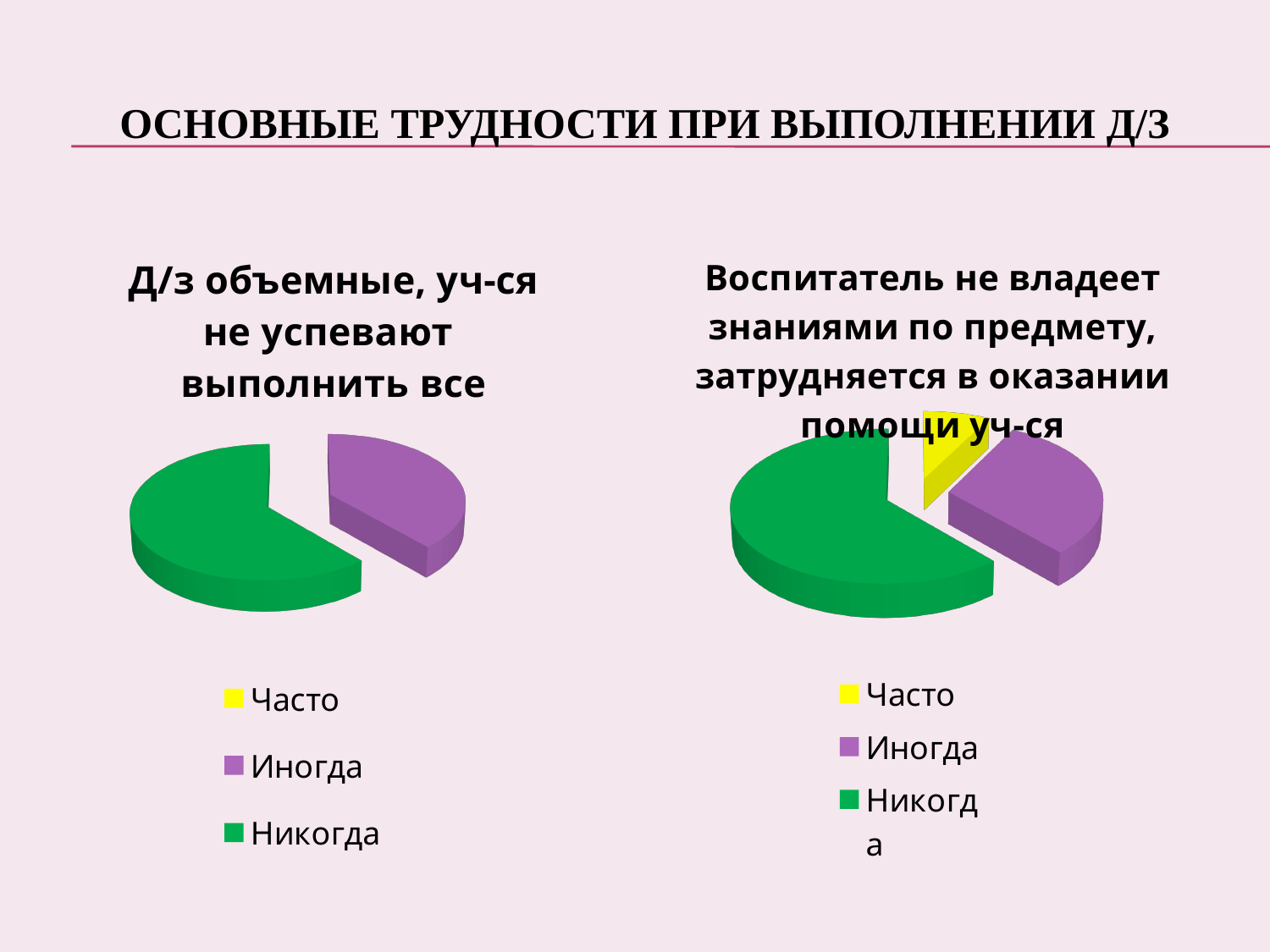
In the left chart ("Д/з объемные, уч-ся не успевают выполнить все"), how many entries does the legend list? 3 In the left chart ("Д/з объемные, уч-ся не успевают выполнить все"), which slice is larger: Иногда or Никогда? Никогда In the right chart ("Воспитатель не владеет знаниями по предмету..."), how many entries does the legend list? 3 In the right chart ("Воспитатель не владеет знаниями по предмету..."), what colour represents the category Часто? yellow In the right chart ("Воспитатель не владеет знаниями по предмету..."), which category has the smallest visible slice? Часто In the right chart ("Воспитатель не владеет знаниями по предмету..."), which category has the largest slice? Никогда In the left chart ("Д/з объемные, уч-ся не успевают выполнить все"), what colour represents the category Никогда? green What kind of chart is the right chart titled "Воспитатель не владеет знаниями по предмету, затрудняется в оказании помощи уч-ся"? pie chart In the right chart ("Воспитатель не владеет знаниями по предмету..."), which slice is larger: Часто or Иногда? Иногда In the left chart ("Д/з объемные, уч-ся не успевают выполнить все"), which category has the largest slice? Никогда What kind of chart is the left chart titled "Д/з объемные, уч-ся не успевают выполнить все"? pie chart